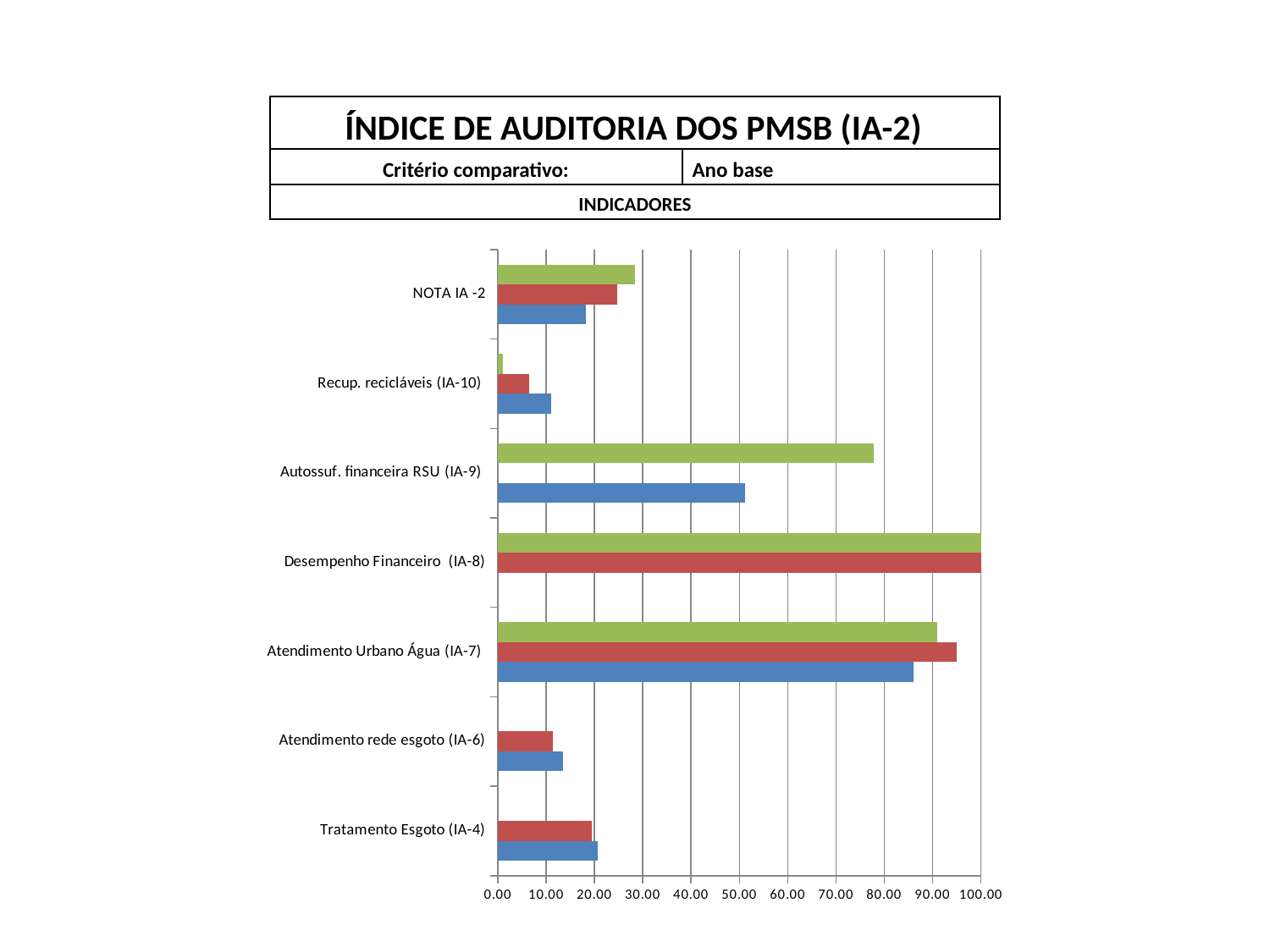
What is the title printed above the chart? ÍNDICE DE AUDITORIA DOS PMSB (IA-2) What kind of chart is shown on the slide? bar chart Is the green bar for Autossuf. financeira RSU (IA-9) greater or less than 70.00? greater Is the green bar for NOTA IA -2 greater or less than 40.00? less Which has the longer blue bar: Atendimento Urbano Água (IA-7) or Atendimento rede esgoto (IA-6)? Atendimento Urbano Água (IA-7) Is the blue bar for Atendimento Urbano Água (IA-7) greater or less than 80.00? greater For Autossuf. financeira RSU (IA-9), which bar is longer: the green bar or the blue bar? the green bar Which category has the longest red bar? Desempenho Financeiro (IA-8) How many categories are shown on the chart's vertical axis? 7